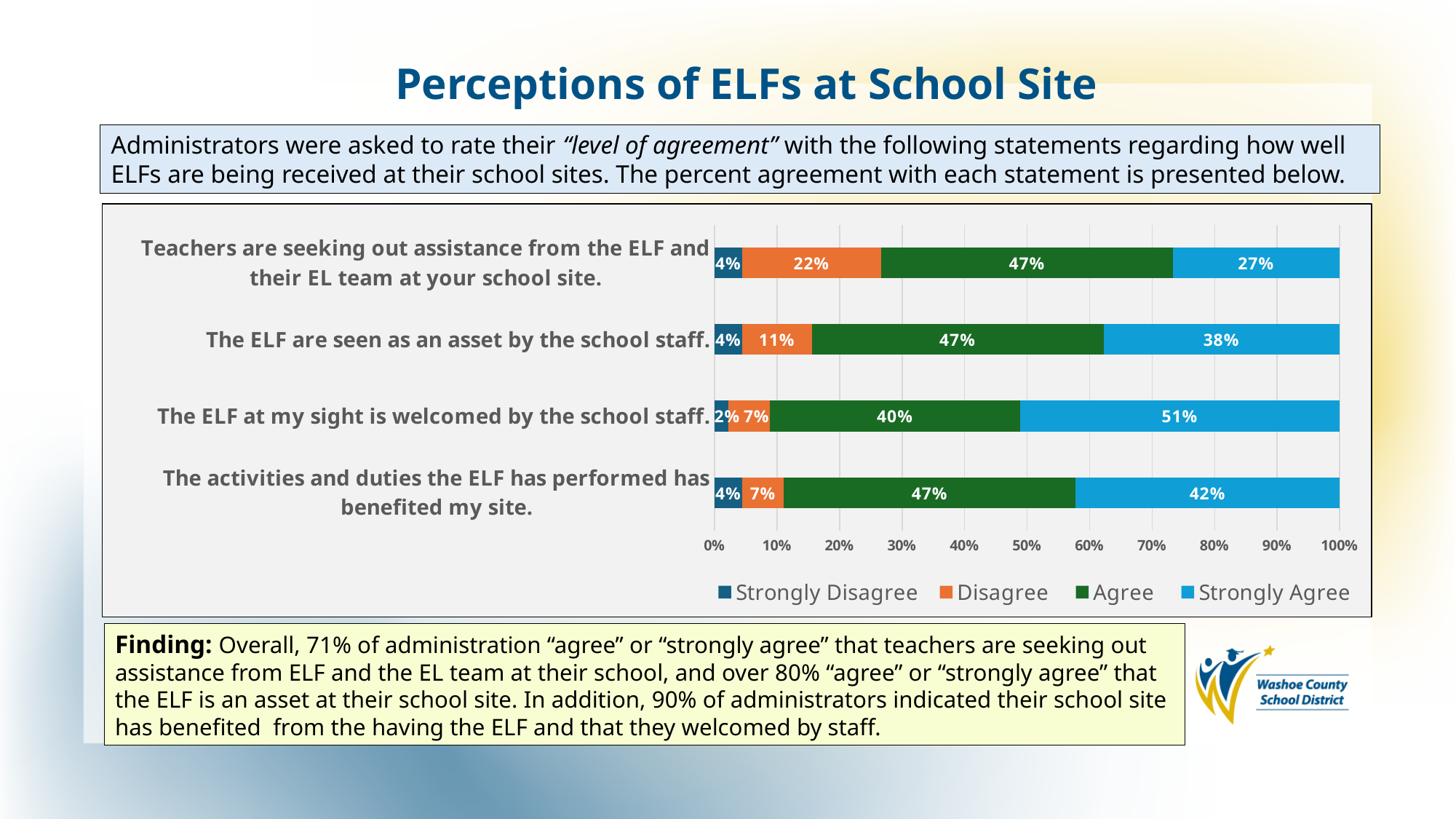
What is the difference between the Strongly Agree values for "The ELF are seen as an asset by the school staff." and "Teachers are seeking out assistance from the ELF and their EL team at your school site."? 11% What is the Strongly Disagree value for "The activities and duties the ELF has performed has benefited my site."? 4% Which statement has the highest Strongly Agree value? The ELF at my sight is welcomed by the school staff. What is the Strongly Agree value for "The ELF at my sight is welcomed by the school staff."? 51% What is the Disagree value for "Teachers are seeking out assistance from the ELF and their EL team at your school site."? 22% What is the Agree value for "The ELF are seen as an asset by the school staff."? 47% Which statement has the lowest Strongly Agree value? Teachers are seeking out assistance from the ELF and their EL team at your school site. Which is larger: the Disagree value for "The ELF are seen as an asset by the school staff." or the Disagree value for "The ELF at my sight is welcomed by the school staff."? The ELF are seen as an asset by the school staff. Which series in the legend is shown in orange? Disagree How many statements (categories) are plotted in the chart? 4 How many series does the chart legend list? 4 What kind of chart is shown on the slide? Stacked bar chart